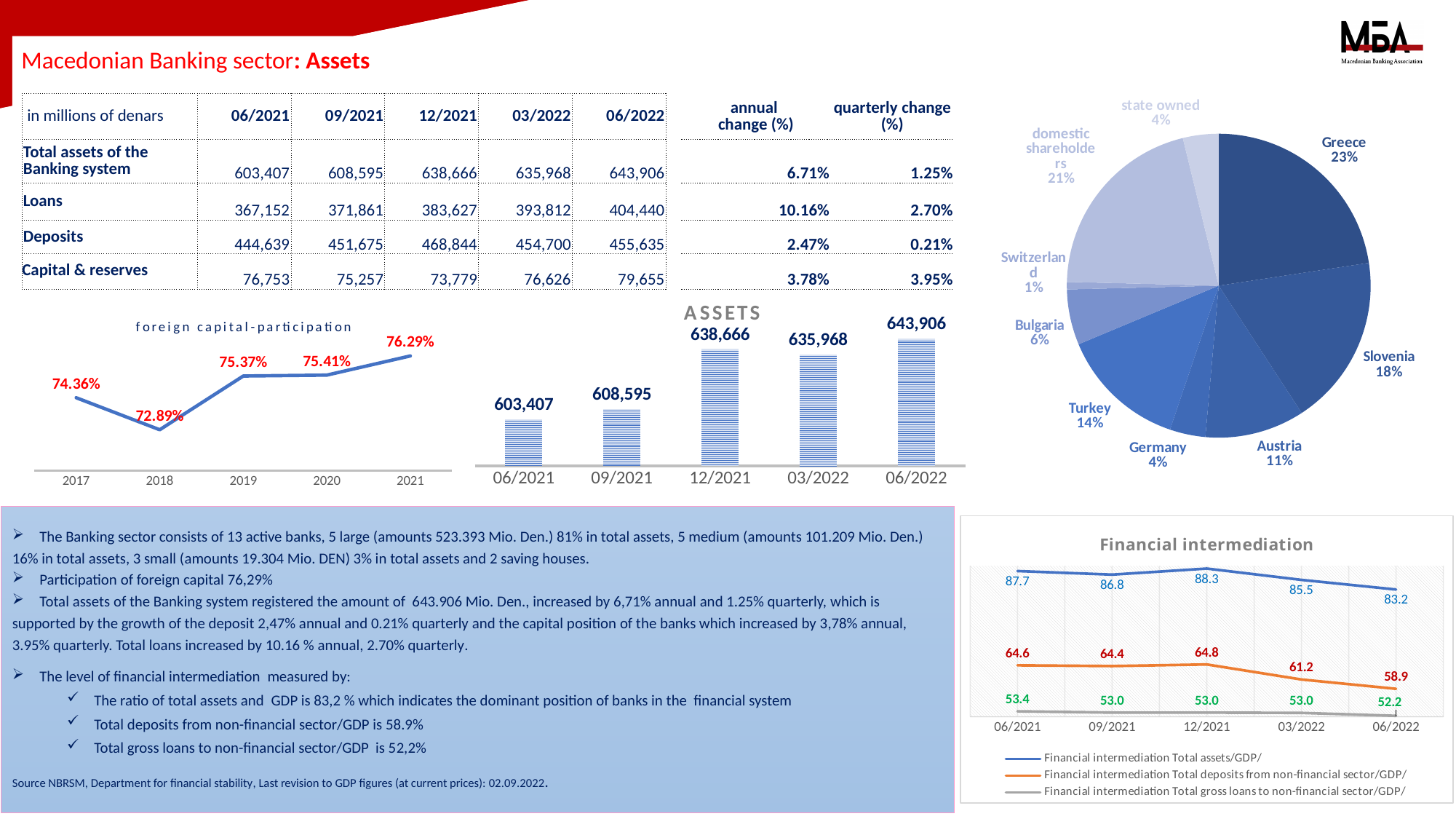
In the pie chart at the top right, which is larger, Turkey or Austria? Turkey In the ASSETS bar chart, what is the value for 06/2022? 643,906 In the foreign capital-participation line chart, which year has the highest value? 2021 In the ASSETS bar chart, which period has the lowest value? 06/2021 In the ASSETS bar chart, how many periods are shown on the x axis? 5 What kind of chart is the ASSETS chart? bar chart In the foreign capital-participation line chart, what is the value for 2018? 72.89% In the pie chart at the top right, which slice is the smallest? Switzerland How many series does the legend of the Financial intermediation chart list? 3 In the ASSETS bar chart, what is the difference between the 12/2021 and 06/2021 values? 35,259 In the Financial intermediation chart, what is the value of Total assets/GDP for 06/2022? 83.2 In the pie chart at the top right, what share does Greece have? 23%